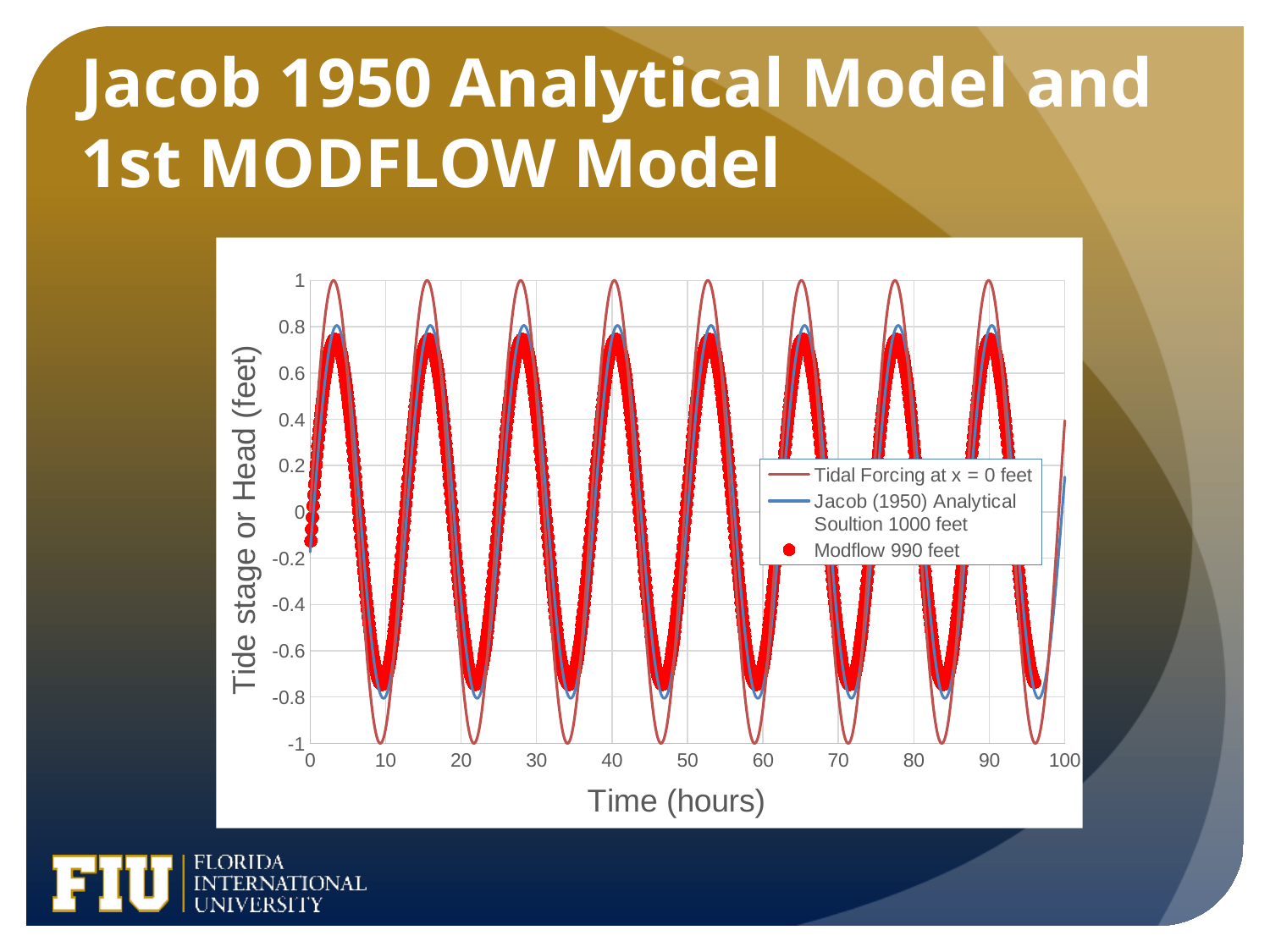
What is the lowest value reached by the Tidal Forcing at x = 0 feet series? -1 What is the largest value shown on the x axis? 100 Which series reaches a higher peak, Tidal Forcing at x = 0 feet or Jacob (1950) Analytical Soultion 1000 feet? Tidal Forcing at x = 0 feet How many peaks does the Tidal Forcing at x = 0 feet series have between 0 and 100 hours? 8 Is the lowest value of the Modflow 990 feet series greater or less than -0.8? greater How many series does the legend list? 3 What is the title of the y axis? Tide stage or Head (feet) What is the peak value reached by the Tidal Forcing at x = 0 feet series? 1 Is the peak value of the Modflow 990 feet series greater or less than 0.8? less What is the title of the x axis? Time (hours) What kind of chart is shown on the slide? line chart